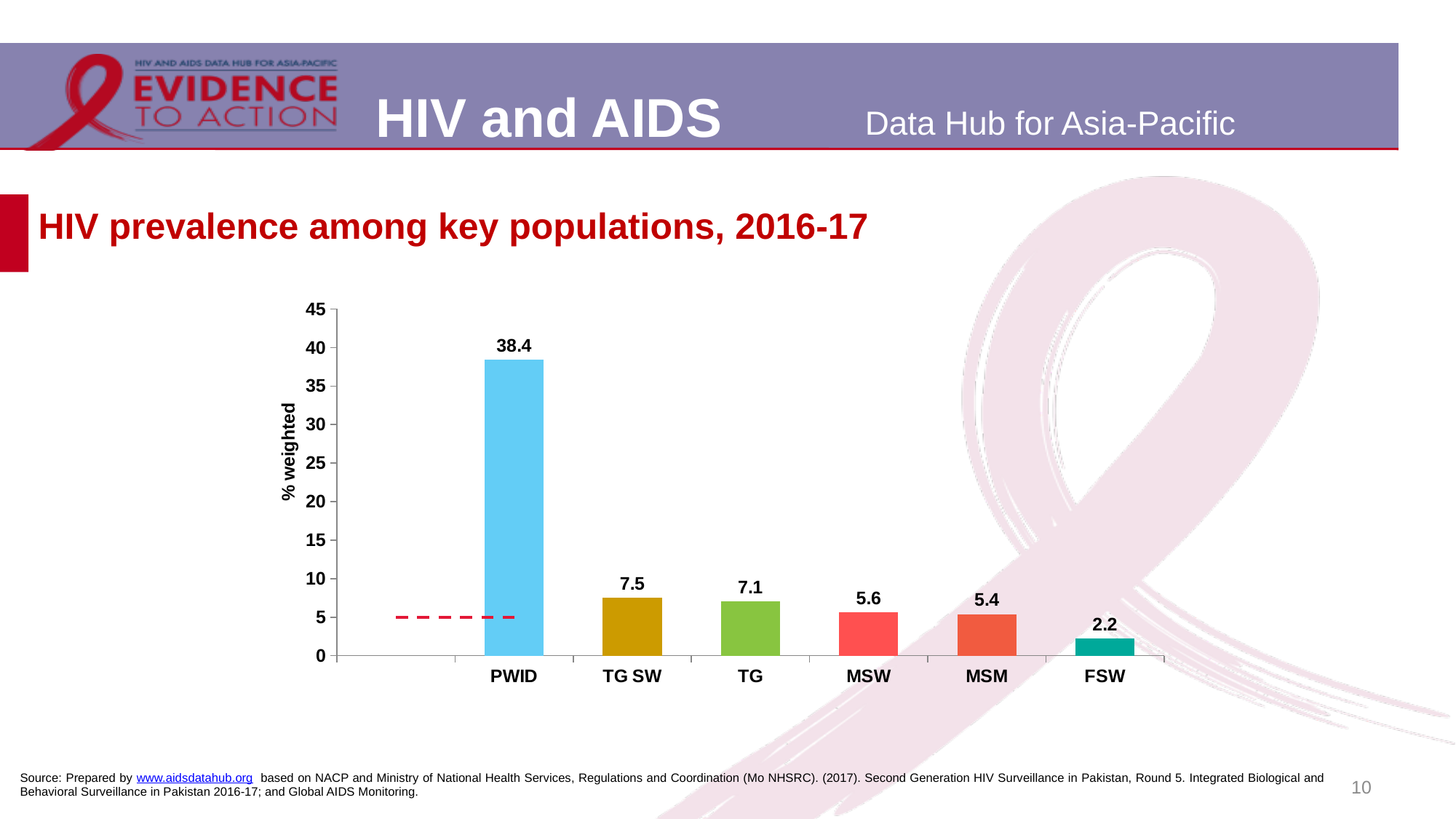
What is the difference between the values for TG and FSW? 4.9 What is the HIV prevalence value shown for PWID? 38.4 What kind of chart is shown on the slide? Bar chart Which key population has the highest HIV prevalence? PWID How many key populations are shown on the x axis? 6 What is the value shown for TG SW? 7.5 What is the value shown for MSM? 5.4 Which key population has the lowest HIV prevalence? FSW What is the difference between the values for PWID and TG SW? 30.9 Which has a higher value, MSW or MSM? MSW What is the label of the y axis? % weighted What is the value shown for FSW? 2.2